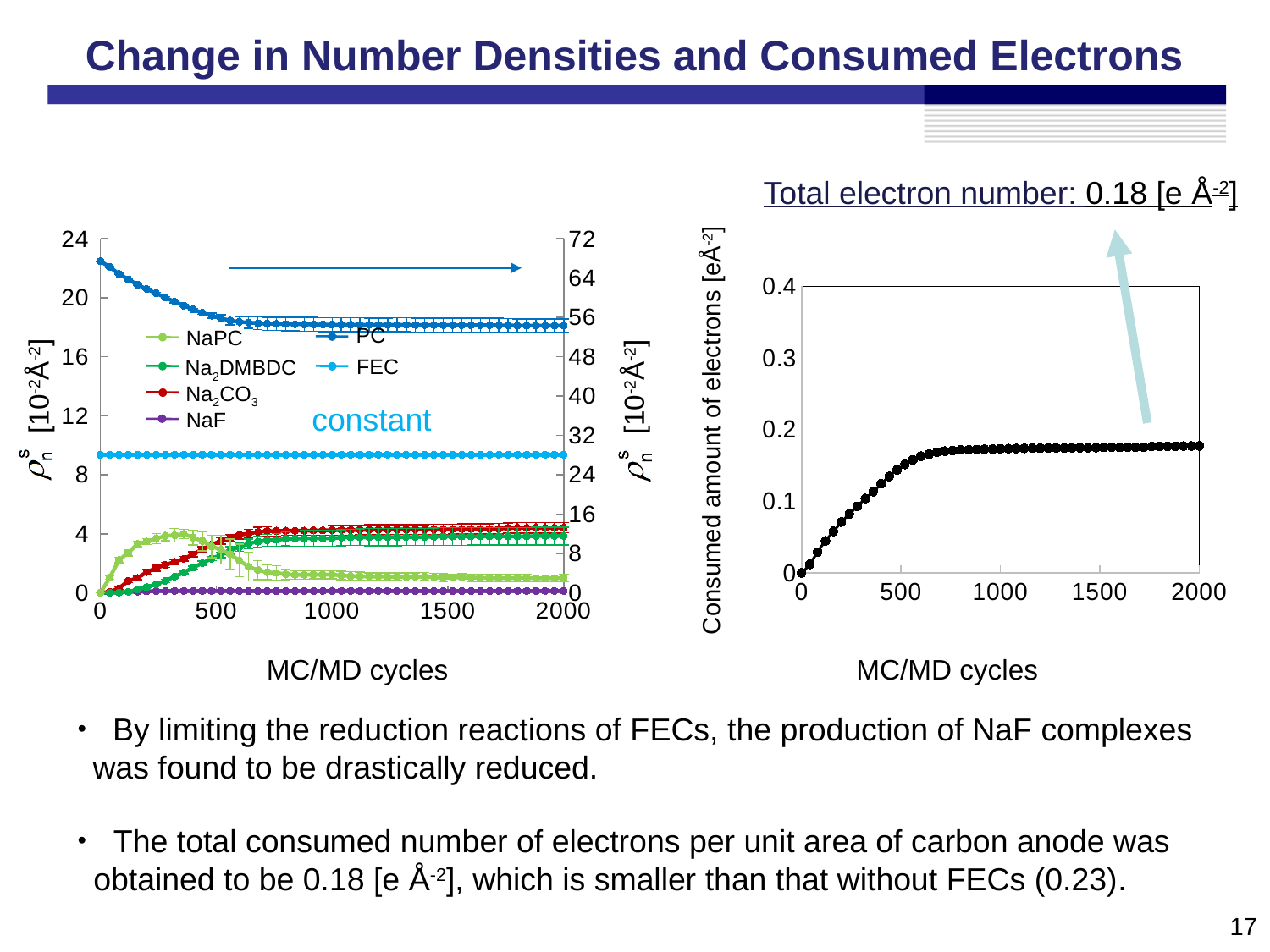
How many series does the legend of the left chart list? 6 What kind of chart is the left chart showing number densities? line chart What kind of chart is the right chart showing consumed amount of electrons? line chart In the left chart, is the value of NaPC at 2000 cycles greater or less than 4 on the left axis? less What is the x-axis label of the right chart? MC/MD cycles In the right chart, is the consumed amount of electrons at 500 cycles greater or less than 0.1? greater What total electron number is stated above the right chart? 0.18 [e Å-2] In the left chart, does the PC series rise or fall as MC/MD cycles increase? fall In the right chart, is the consumed amount of electrons at 2000 cycles greater or less than 0.2? less In the left chart, which series is labelled as 'constant'? FEC In the left chart, which series has the lowest values across the whole range of cycles? NaF